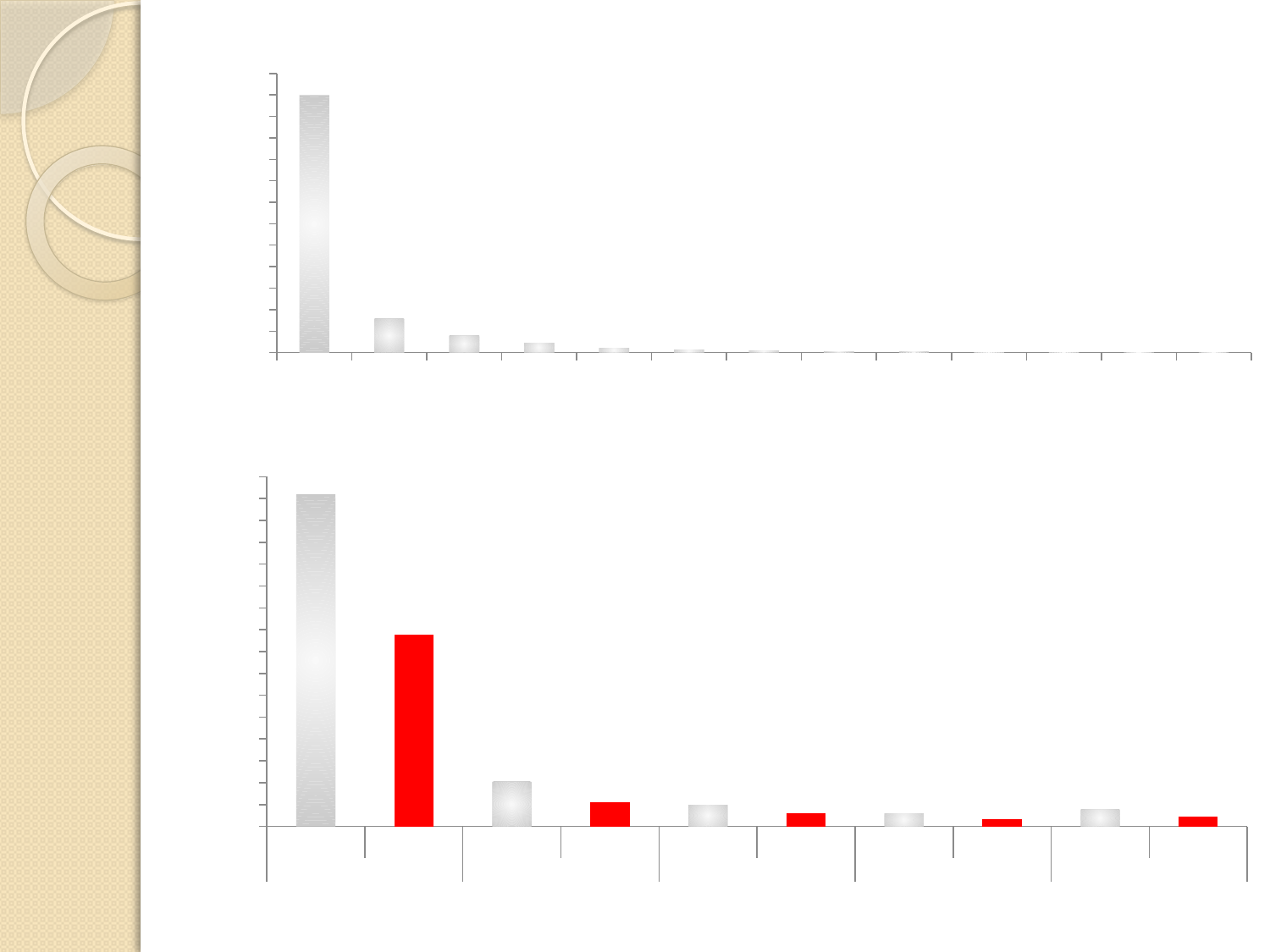
In the bottom chart, which is taller: the second bar or the third bar? the second bar In the top chart, which bar is the highest? the leftmost (first) bar In the bottom chart, what colour is the second bar from the left? red In the bottom chart, which bar is the highest? the leftmost (first) bar In the bottom chart, what two colours are the bars? grey and red What kind of chart is the bottom chart on the slide? bar chart In the top chart, do the bar values rise or fall from left to right? fall What kind of chart is the top chart on the slide? bar chart In the bottom chart, how many bars are plotted? 10 In the bottom chart, which is taller: the first bar or the second bar? the first bar